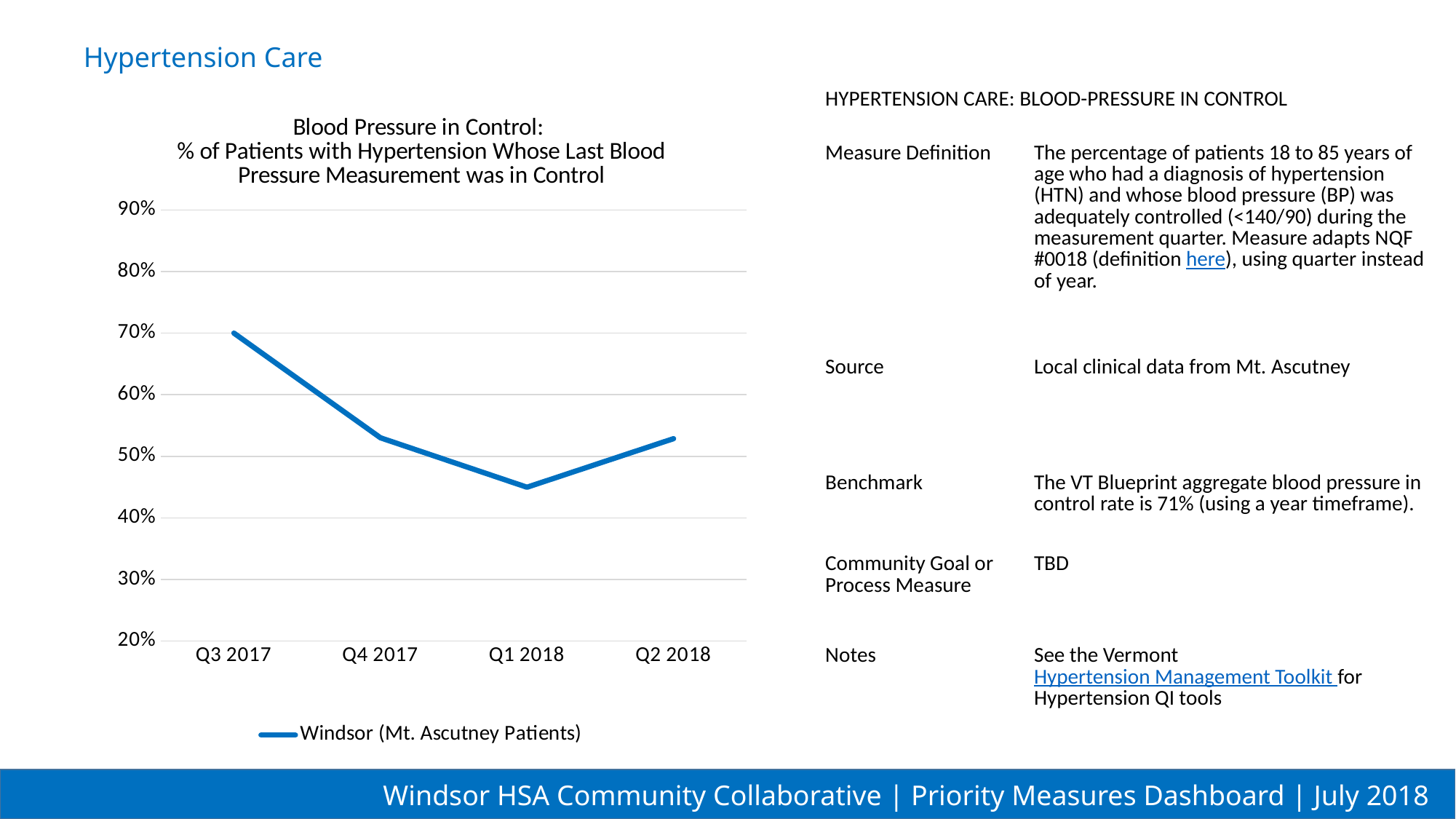
How many series does the chart legend list? 1 Is the value for Q4 2017 greater or less than 50%? greater Is the value for Q1 2018 greater or less than 40%? greater Which is larger, the value for Q3 2017 or the value for Q1 2018? Q3 2017 Is the value for Q1 2018 greater or less than 50%? less What kind of chart is shown on the slide? line chart How many quarters are plotted on the x axis of the chart? 4 Which quarter has the highest value in the chart? Q3 2017 What series name is shown in the chart legend? Windsor (Mt. Ascutney Patients) Which quarter has the lowest value in the chart? Q1 2018 What is the value for Q3 2017 in the chart? 70% Does the value rise or fall from Q3 2017 to Q1 2018? fall